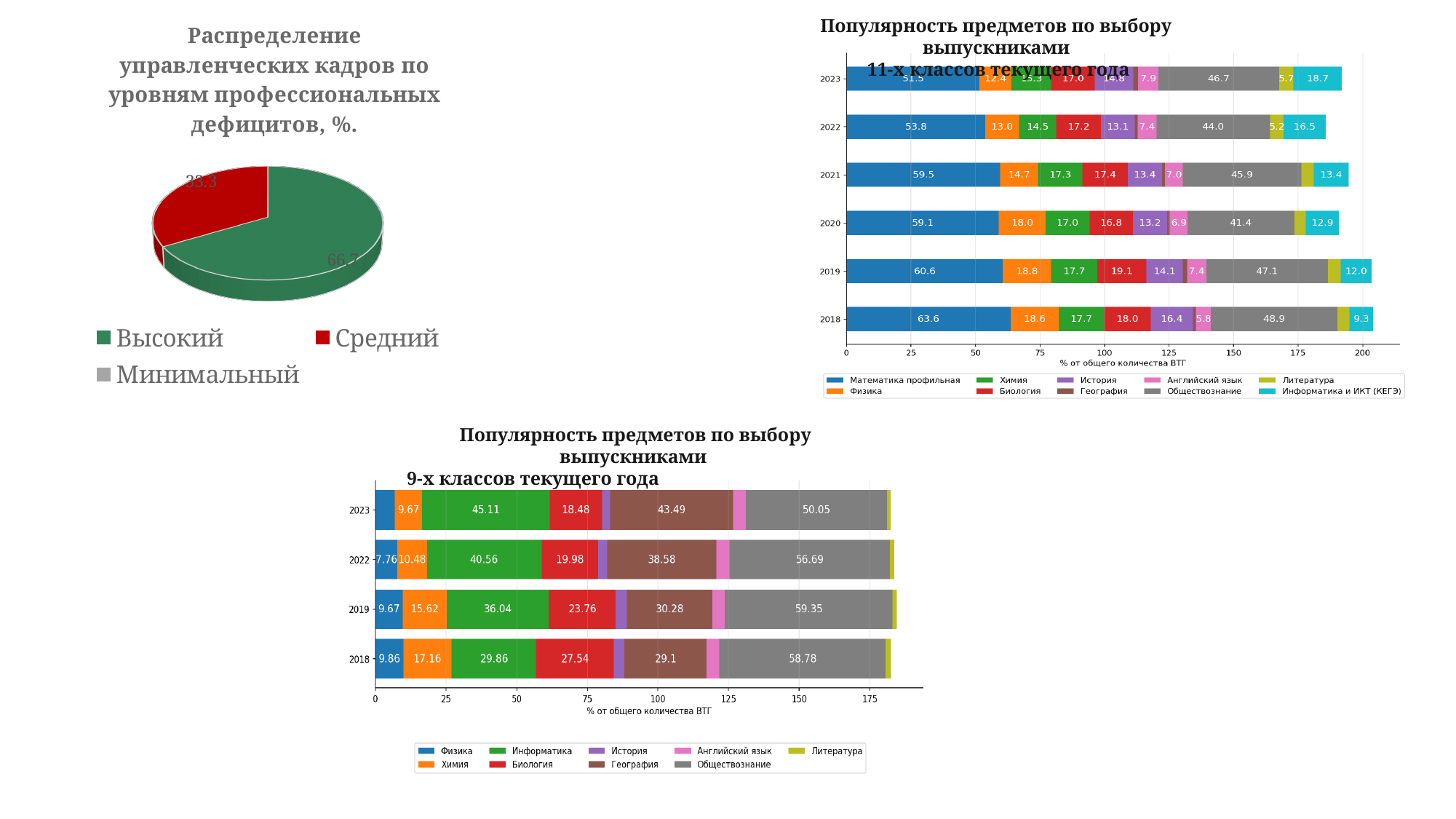
In the chart 'Популярность предметов по выбору выпускниками 11-х классов текущего года', how many years are shown? 6 What kind of chart is the top-left chart 'Распределение управленческих кадров по уровням профессиональных дефицитов'? pie chart In the chart 'Популярность предметов по выбору выпускниками 11-х классов текущего года', what is the value for Обществознание in 2022? 44.0 In the chart 'Популярность предметов по выбору выпускниками 11-х классов текущего года', what is the difference between the Физика values for 2018 and 2022? 5.6 In the chart 'Популярность предметов по выбору выпускниками 11-х классов текущего года', what is the value for Математика профильная in 2018? 63.6 In the chart 'Популярность предметов по выбору выпускниками 9-х классов текущего года', how many years are shown? 4 How many entries does the legend of the pie chart 'Распределение управленческих кадров по уровням профессиональных дефицитов' list? 3 In the chart 'Популярность предметов по выбору выпускниками 11-х классов текущего года', how many series does the legend list? 10 In the chart 'Популярность предметов по выбору выпускниками 11-х классов текущего года', does the value for Математика профильная rise or fall from 2018 to 2023? fall In the chart 'Популярность предметов по выбору выпускниками 9-х классов текущего года', which year has the larger value for Информатика, 2018 or 2023? 2023 In the chart 'Популярность предметов по выбору выпускниками 9-х классов текущего года', what is the value for Обществознание in 2019? 59.35 In the pie chart 'Распределение управленческих кадров по уровням профессиональных дефицитов', what is the value for Высокий? 66.7